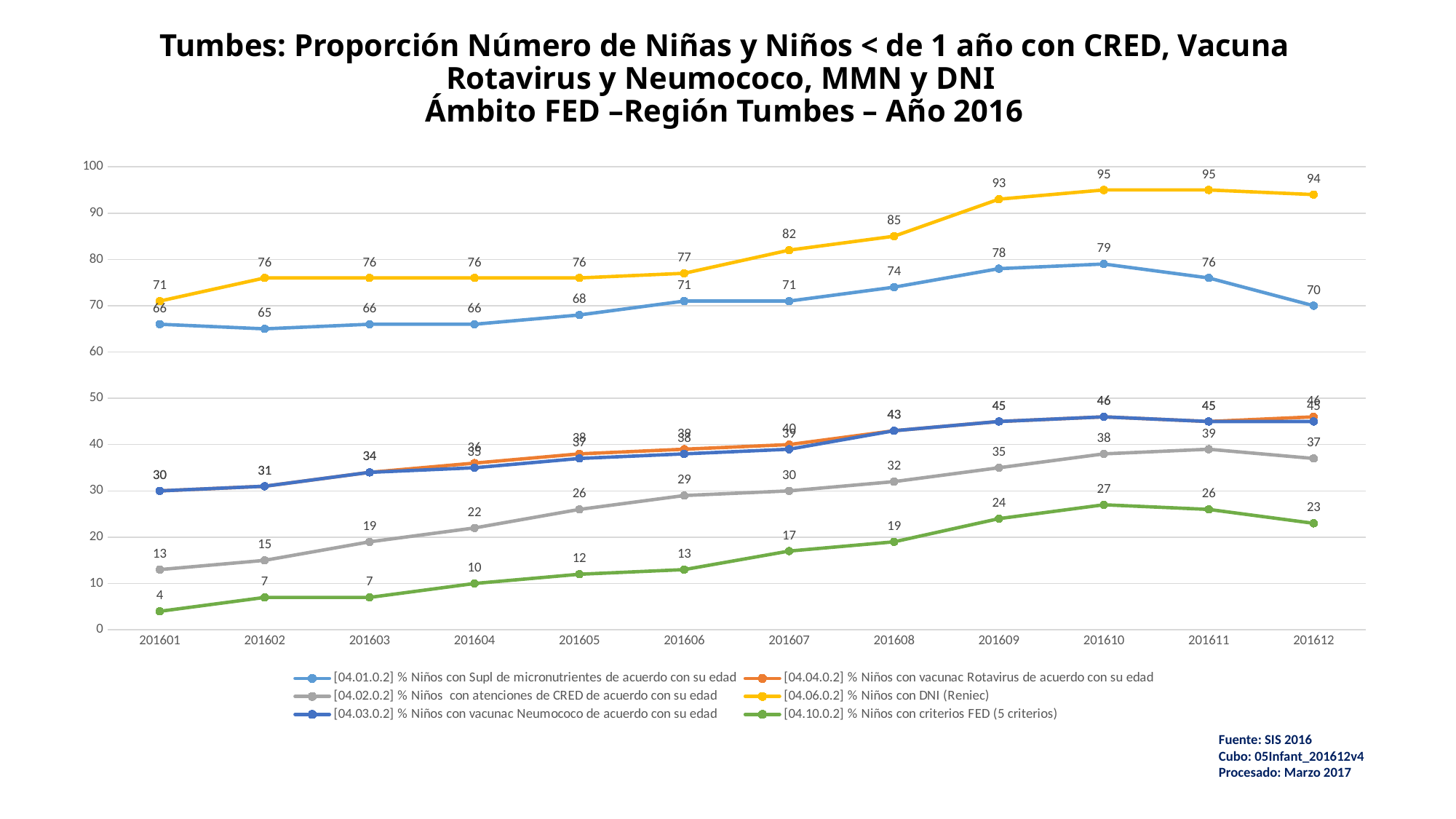
What is the value for % Niños con criterios FED (5 criterios) in 201601? 4 What is the difference between the % Niños con DNI (Reniec) values in 201612 and 201601? 23 Which is larger in 201608: % Niños con atenciones de CRED de acuerdo con su edad or % Niños con criterios FED (5 criterios)? % Niños con atenciones de CRED de acuerdo con su edad What is the value for % Niños con DNI (Reniec) in 201609? 93 In which month is % Niños con criterios FED (5 criterios) highest? 201610 How many months are plotted along the x axis? 12 How many series does the legend list? 6 What type of chart is shown on the slide? line chart What is the value for % Niños con atenciones de CRED de acuerdo con su edad in 201611? 39 In which month is % Niños con Supl de micronutrientes de acuerdo con su edad lowest? 201602 Does % Niños con atenciones de CRED de acuerdo con su edad generally rise or fall from 201601 to 201611? rise What is the value for % Niños con Supl de micronutrientes de acuerdo con su edad in 201610? 79